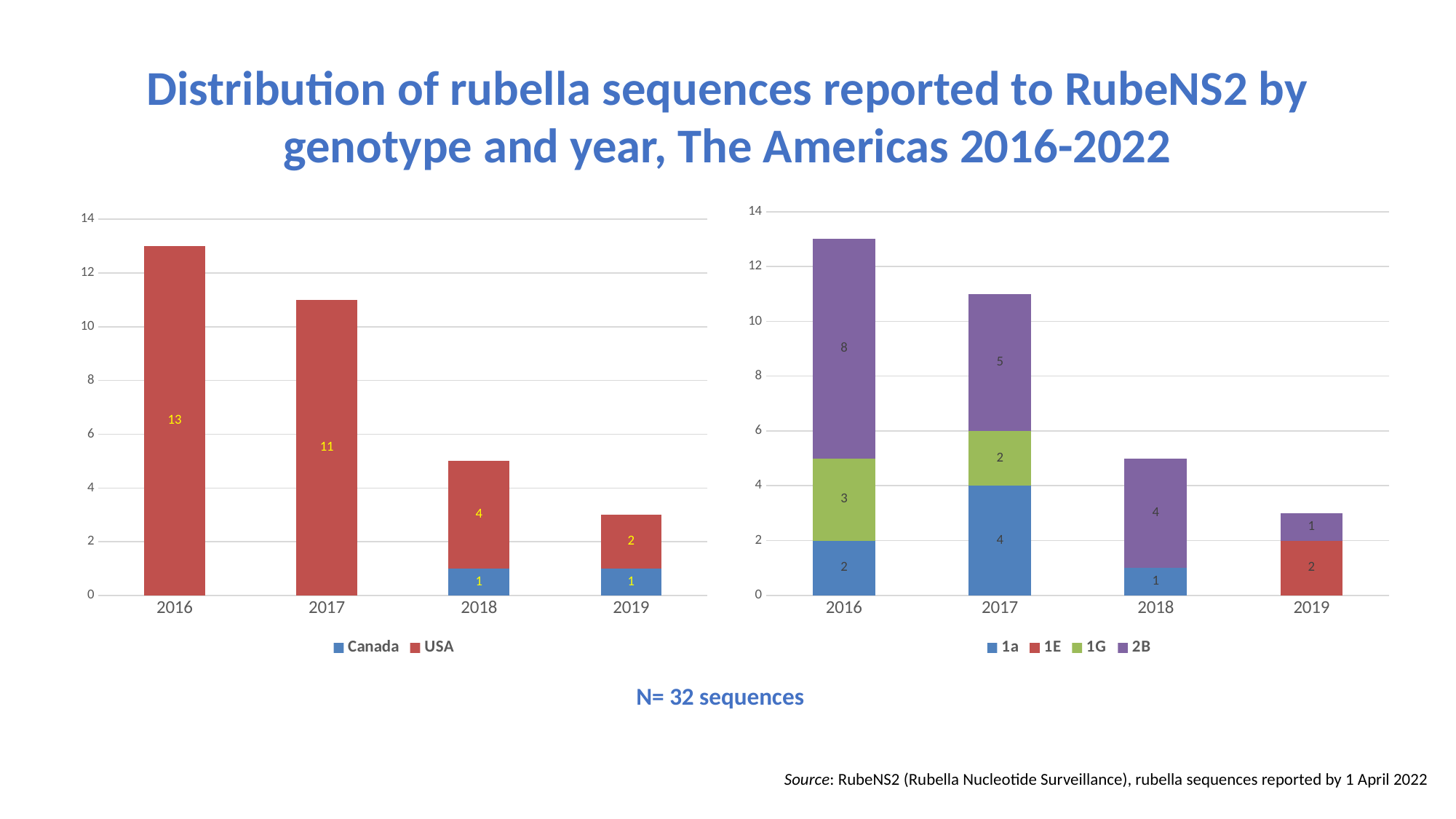
What kind of chart is the right chart (genotypes)? stacked bar chart In the left chart (Canada/USA), what is the total height of the stacked bar for 2019? 3 In the left chart (Canada/USA), do the USA values rise or fall from 2016 to 2019? fall In the left chart (Canada/USA), what is the Canada value for 2018? 1 In the left chart (Canada/USA), what is the difference between the USA values for 2016 and 2017? 2 In the right chart (genotypes), how many series does the legend list? 4 In the right chart (genotypes), what is the value for genotype 1a in 2017? 4 In the left chart (Canada/USA), how many series does the legend list? 2 In the left chart (Canada/USA), what is the USA value for 2016? 13 In the right chart (genotypes), which year has the lowest total stacked bar? 2019 In the right chart (genotypes), what is the value for genotype 2B in 2016? 8 In the right chart (genotypes), what is the total of the stacked bar for 2017? 11